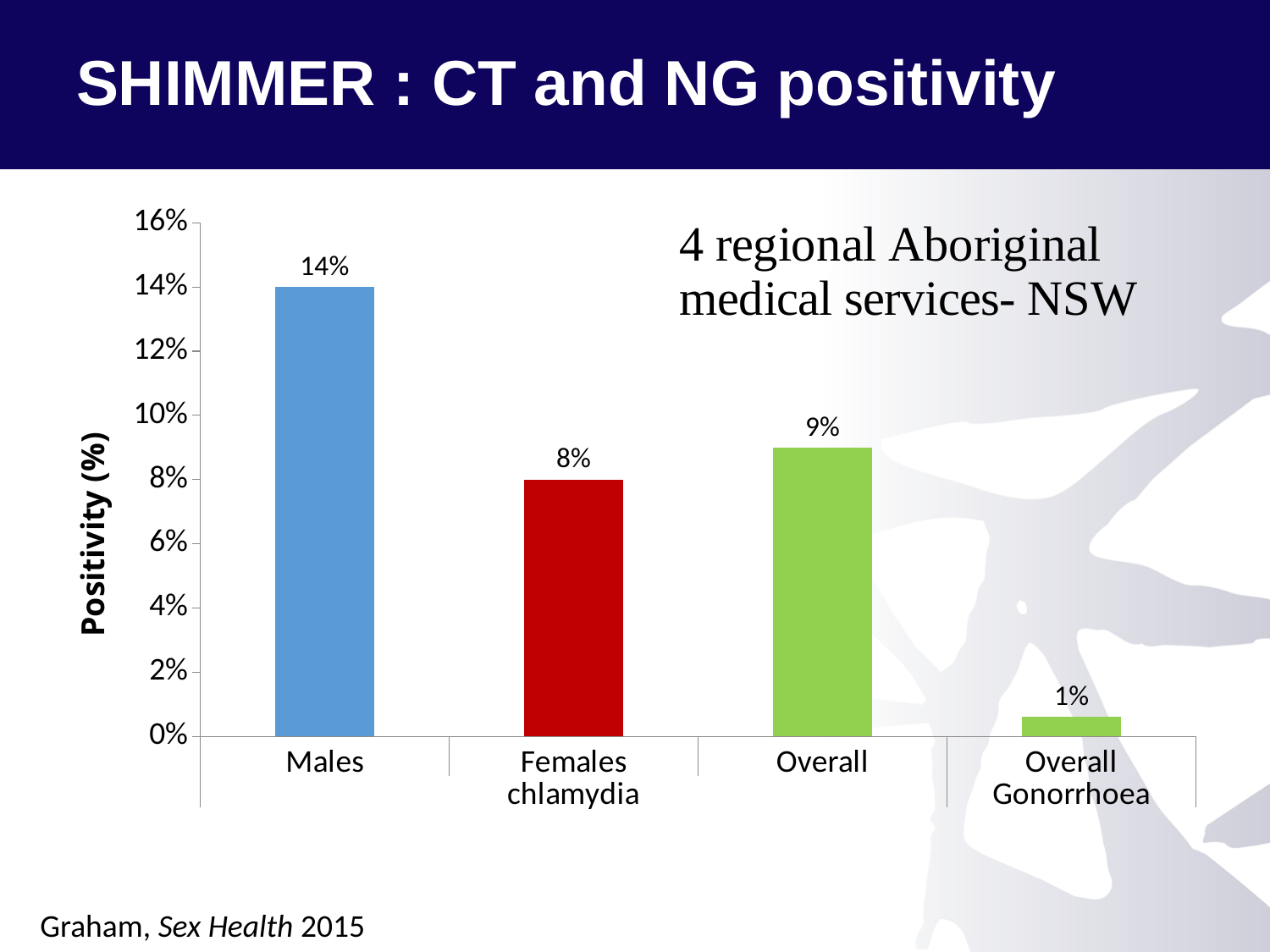
Which category has the highest positivity? Males Which is larger, the positivity for Overall or for Females chlamydia? Overall What is the positivity value for Overall? 9% What is the difference in positivity between Overall and Overall Gonorrhoea? 8% What kind of chart is shown on the slide? Bar chart What is the positivity value for Overall Gonorrhoea? 1% Which category has the lowest positivity? Overall Gonorrhoea How many categories are shown on the x axis? 4 What is the difference in positivity between Males and Females chlamydia? 6% What is the positivity value for Females chlamydia? 8% What is the label of the y axis? Positivity (%) What is the positivity value for Males? 14%